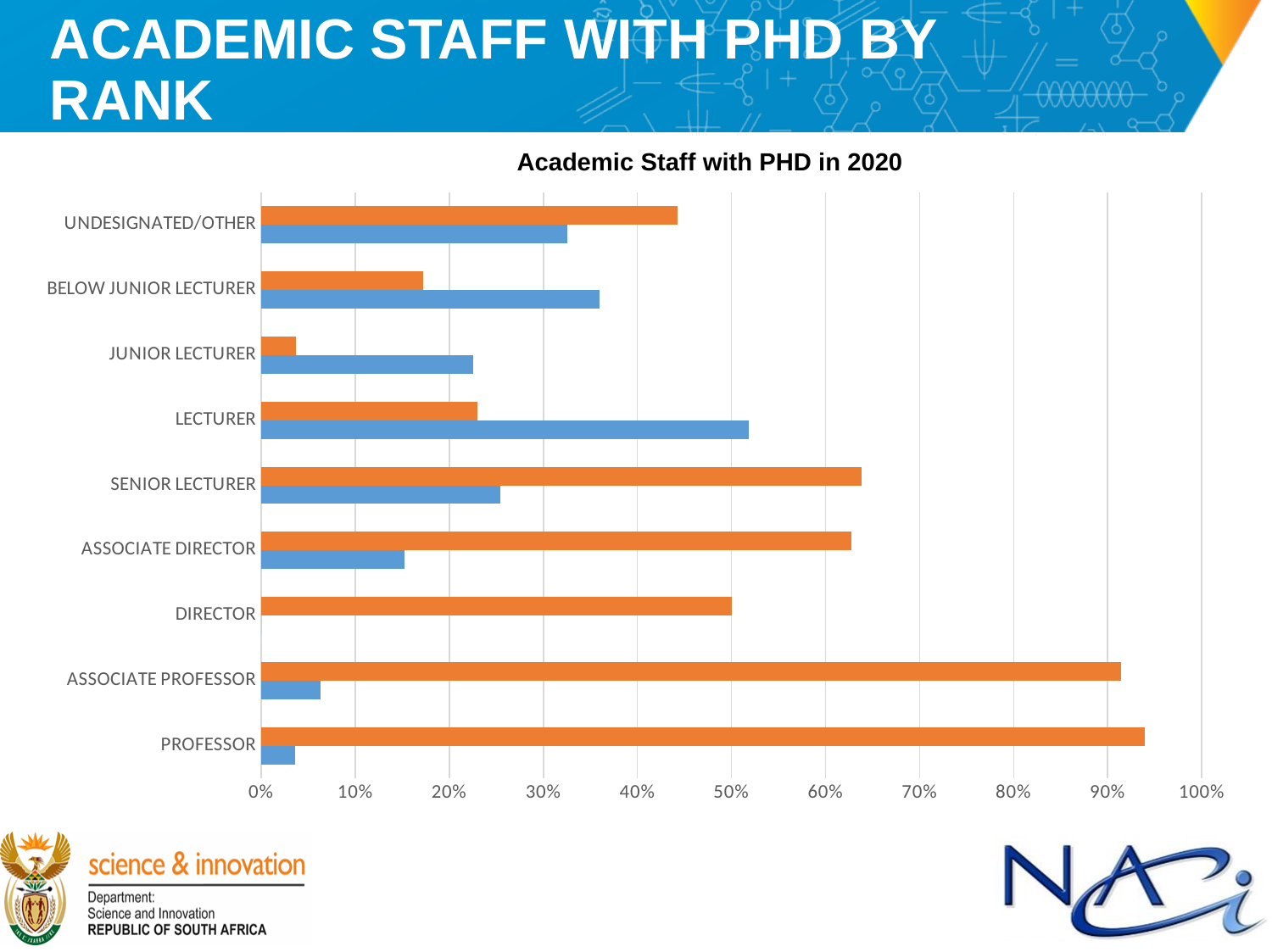
Which rank has the shortest orange bar? JUNIOR LECTURER How many rank categories are shown on the chart? 9 Is the blue bar for LECTURER greater or less than 50%? greater Is the orange bar for UNDESIGNATED/OTHER greater or less than 40%? greater Is the blue bar for ASSOCIATE DIRECTOR greater or less than 20%? less What is the title of the chart? Academic Staff with PHD in 2020 Which rank has the longest orange bar? PROFESSOR Which rank has the longest blue bar? LECTURER What kind of chart is shown on the slide? bar chart Which is larger, the orange bar for ASSOCIATE PROFESSOR or the orange bar for DIRECTOR? ASSOCIATE PROFESSOR